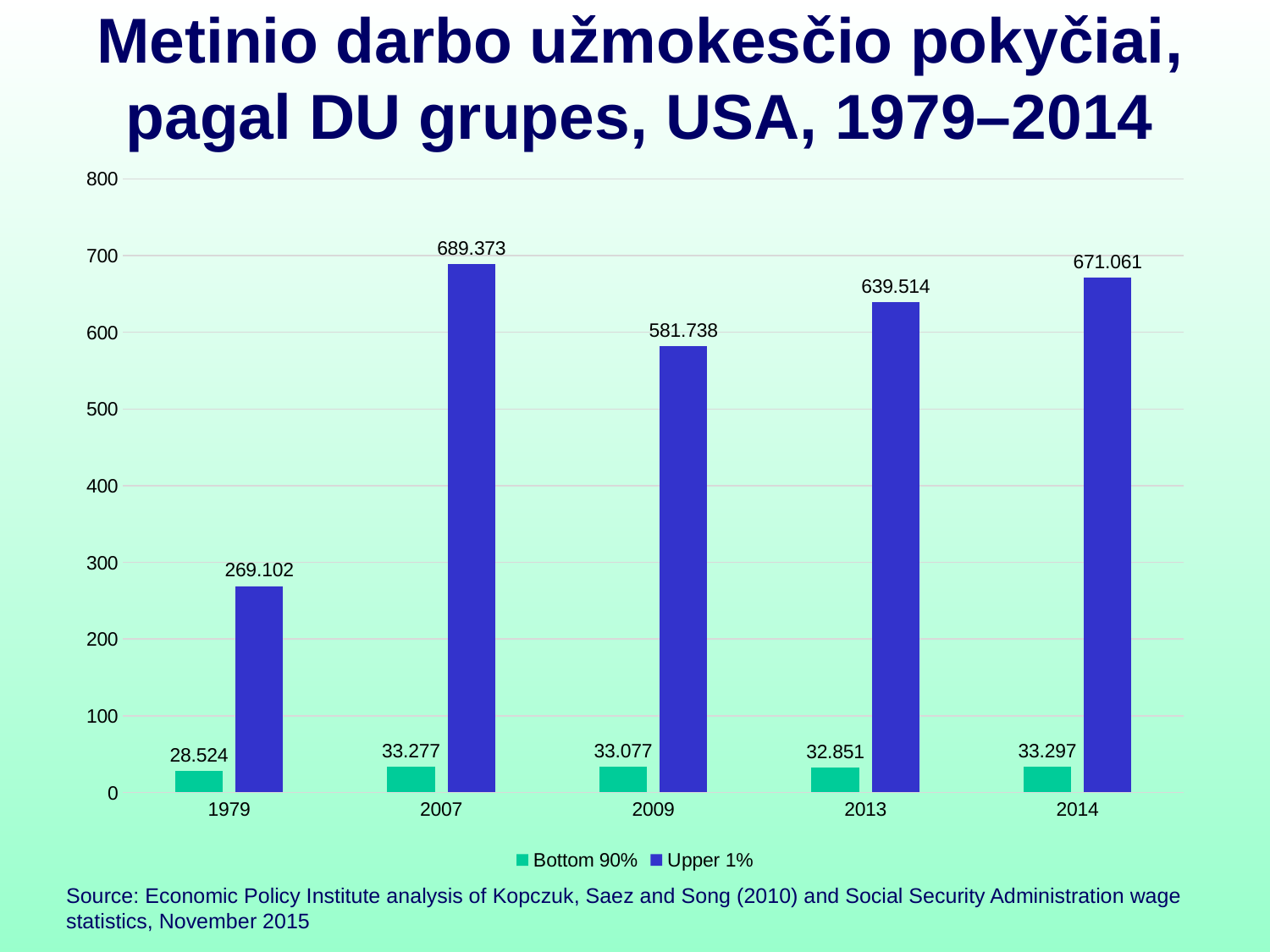
How many years are shown on the x axis? 5 In which year is the Bottom 90% value lowest? 1979 What kind of chart is shown on the slide? Bar chart What is the difference between the Upper 1% values in 2014 and 2013? 31.547 In which year is the Upper 1% value highest? 2007 What is the value for Upper 1% in 2007? 689.373 What is the value for Bottom 90% in 1979? 28.524 What is the difference between the Upper 1% values in 2007 and 1979? 420.271 In which year is the Upper 1% value lowest? 1979 Which is larger, the Upper 1% value in 2009 or in 2013? 2013 What is the value for Upper 1% in 2014? 671.061 How many series does the legend list? 2